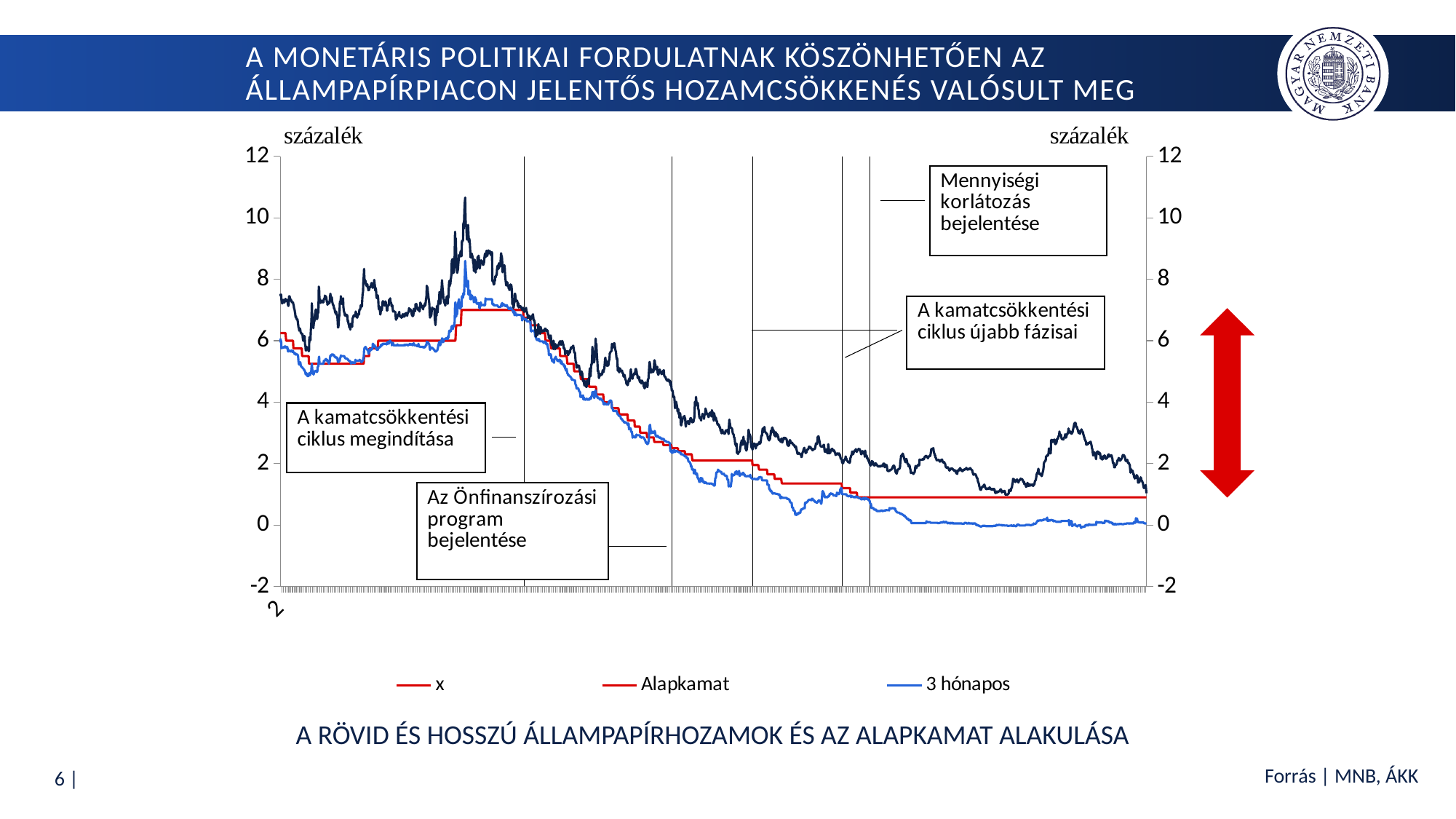
Does the Alapkamat series rise or fall overall from the left to the right of the chart? fall What is the unit label shown above the vertical axes of the chart? százalék Does the 3 hónapos series rise or fall overall from the left to the right of the chart? fall Is the value of the Alapkamat series at the right end of the chart greater or less than 2? less What kind of chart is shown on the slide? line chart Is the peak of the dark navy line greater or less than 10? greater Is the highest value reached by the Alapkamat series greater or less than 6? greater What is the highest value shown on the vertical axis of the chart? 12 What are the three entries in the chart legend? x, Alapkamat, 3 hónapos At the right end of the chart, which is higher: the dark navy line or the 3 hónapos series? the dark navy line How many series does the legend list? 3